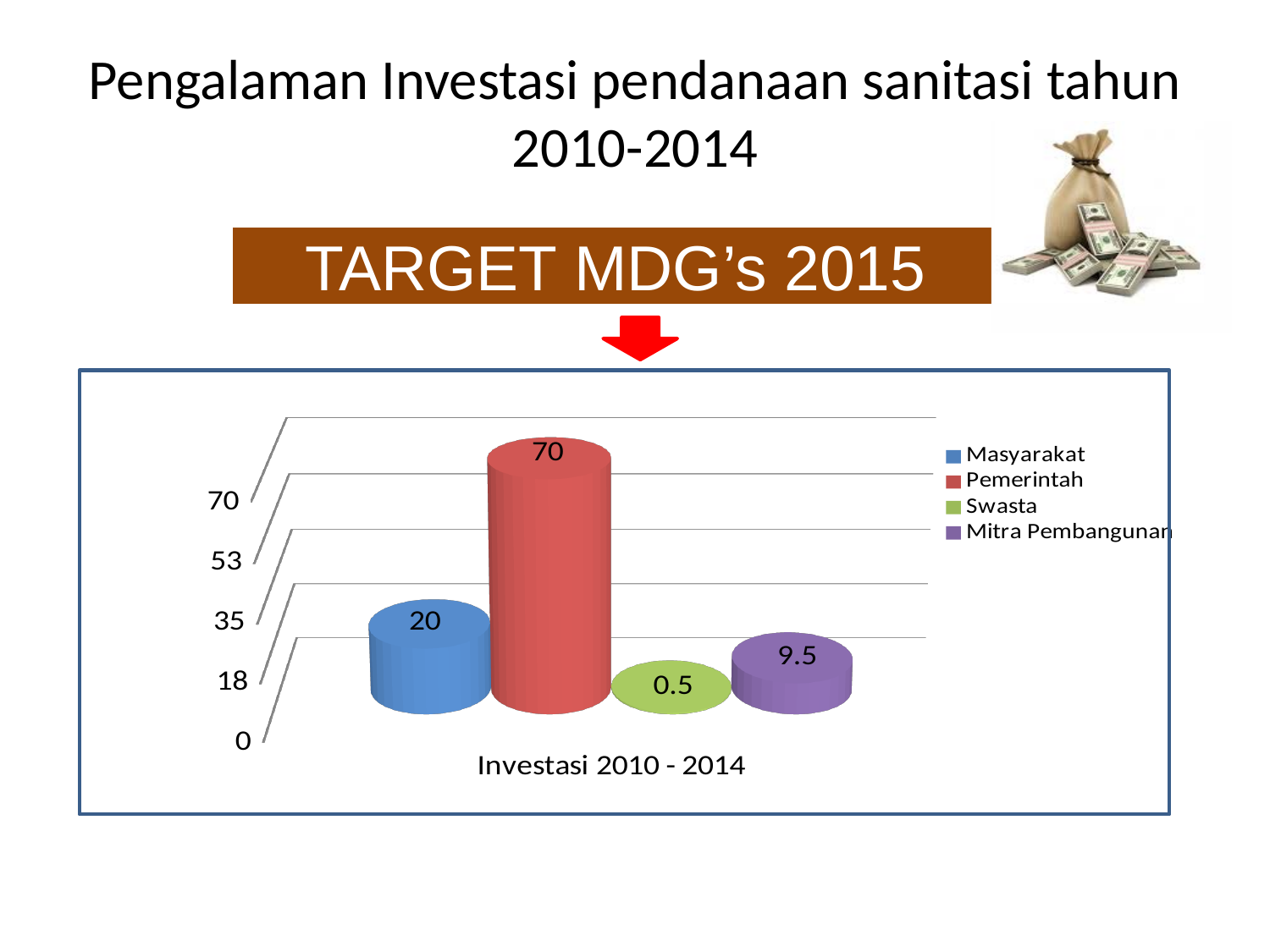
Which series has the lowest value in the chart? Swasta What is the value for Pemerintah in the chart? 70 Which is larger, the value for Masyarakat or the value for Mitra Pembangunan? Masyarakat What is the difference between the values for Pemerintah and Masyarakat? 50 What is the value for Swasta in the chart? 0.5 What is the value for Mitra Pembangunan in the chart? 9.5 What is the value for Masyarakat in the chart? 20 What is the difference between the values for Mitra Pembangunan and Swasta? 9 What is the category label shown on the x axis of the chart? Investasi 2010 - 2014 Which series has the highest value in the chart? Pemerintah What kind of chart is shown on the slide? Bar chart How many series does the legend list? 4